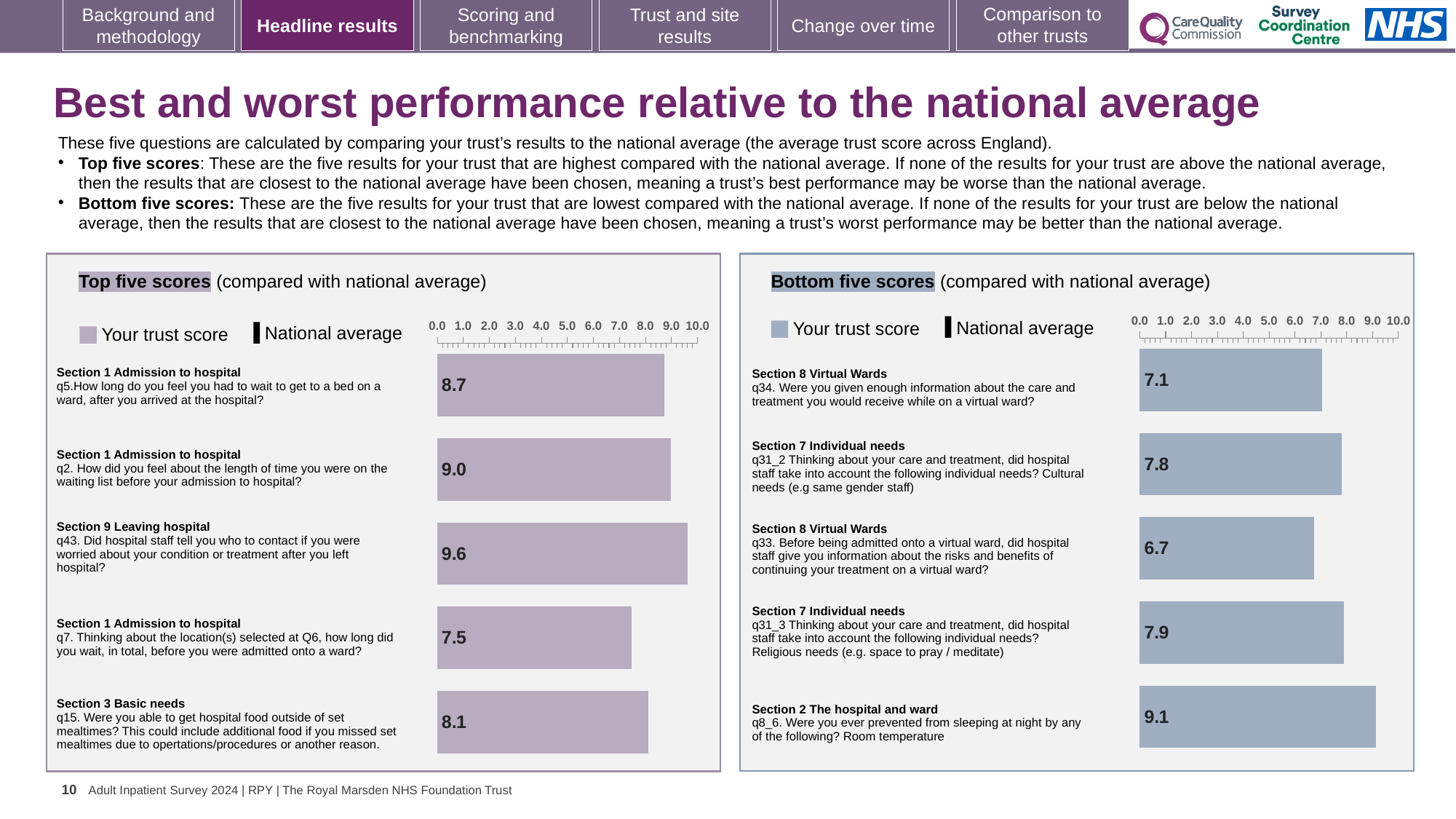
In the Bottom five scores chart, what is the trust score for q33 (Before being admitted onto a virtual ward, did hospital staff give you information about the risks and benefits of continuing your treatment on a virtual ward?)? 6.7 In the Bottom five scores chart, what is the difference between the trust scores for q8_6 and q34? 2.0 In the Top five scores chart, which question has the lowest trust score? q7 (Section 1 Admission to hospital) What kind of chart is the Top five scores chart? Bar chart In the Top five scores chart, which has the larger trust score, q5 or q15? q5 In the Top five scores chart, what is the trust score for q43 (Did hospital staff tell you who to contact if you were worried about your condition or treatment after you left hospital?)? 9.6 In the Bottom five scores chart, which question has the lowest trust score? q33 (Section 8 Virtual Wards) In the Top five scores chart, what is the difference between the trust scores for q2 and q7? 1.5 In the Top five scores chart, which question has the highest trust score? q43 (Section 9 Leaving hospital) In the Top five scores chart, is the trust score for q7 greater or less than 8.0? less How many bars are plotted in the Bottom five scores chart? 5 In the Bottom five scores chart, which question has the highest trust score? q8_6 (Section 2 The hospital and ward)